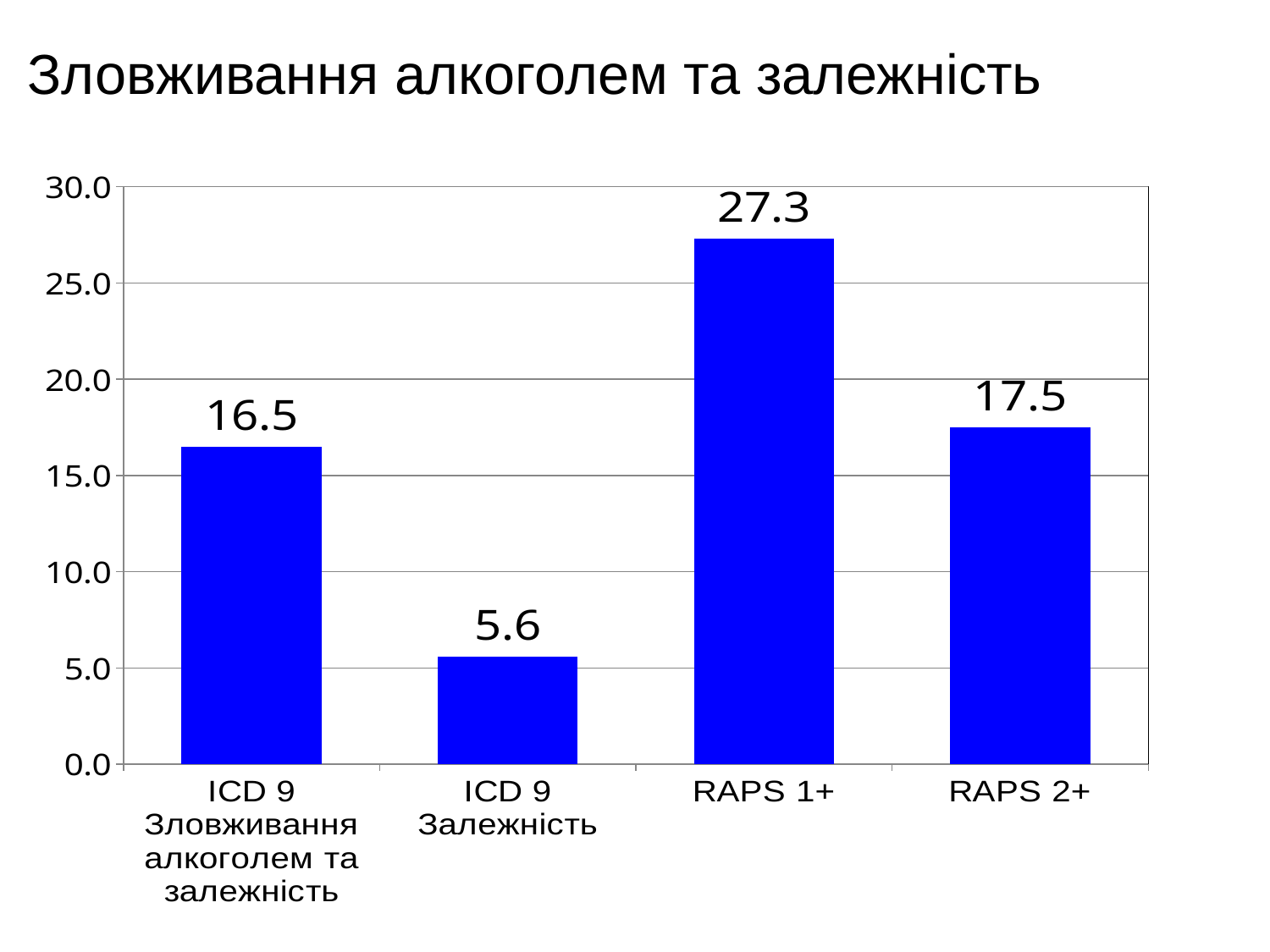
What is the difference between the values for RAPS 1+ and RAPS 2+? 9.8 What is the value for RAPS 1+? 27.3 What is the value for RAPS 2+? 17.5 What is the value for ICD 9 Залежність? 5.6 What is the value for ICD 9 Зловживання алкоголем та залежність? 16.5 Is the value for RAPS 1+ greater or less than 25.0? greater Which is larger, the value for RAPS 2+ or the value for ICD 9 Зловживання алкоголем та залежність? RAPS 2+ How many categories are shown on the chart? 4 Which category has the lowest value? ICD 9 Залежність Which category has the highest value? RAPS 1+ What is the difference between the values for ICD 9 Зловживання алкоголем та залежність and ICD 9 Залежність? 10.9 What kind of chart is shown on the slide? bar chart